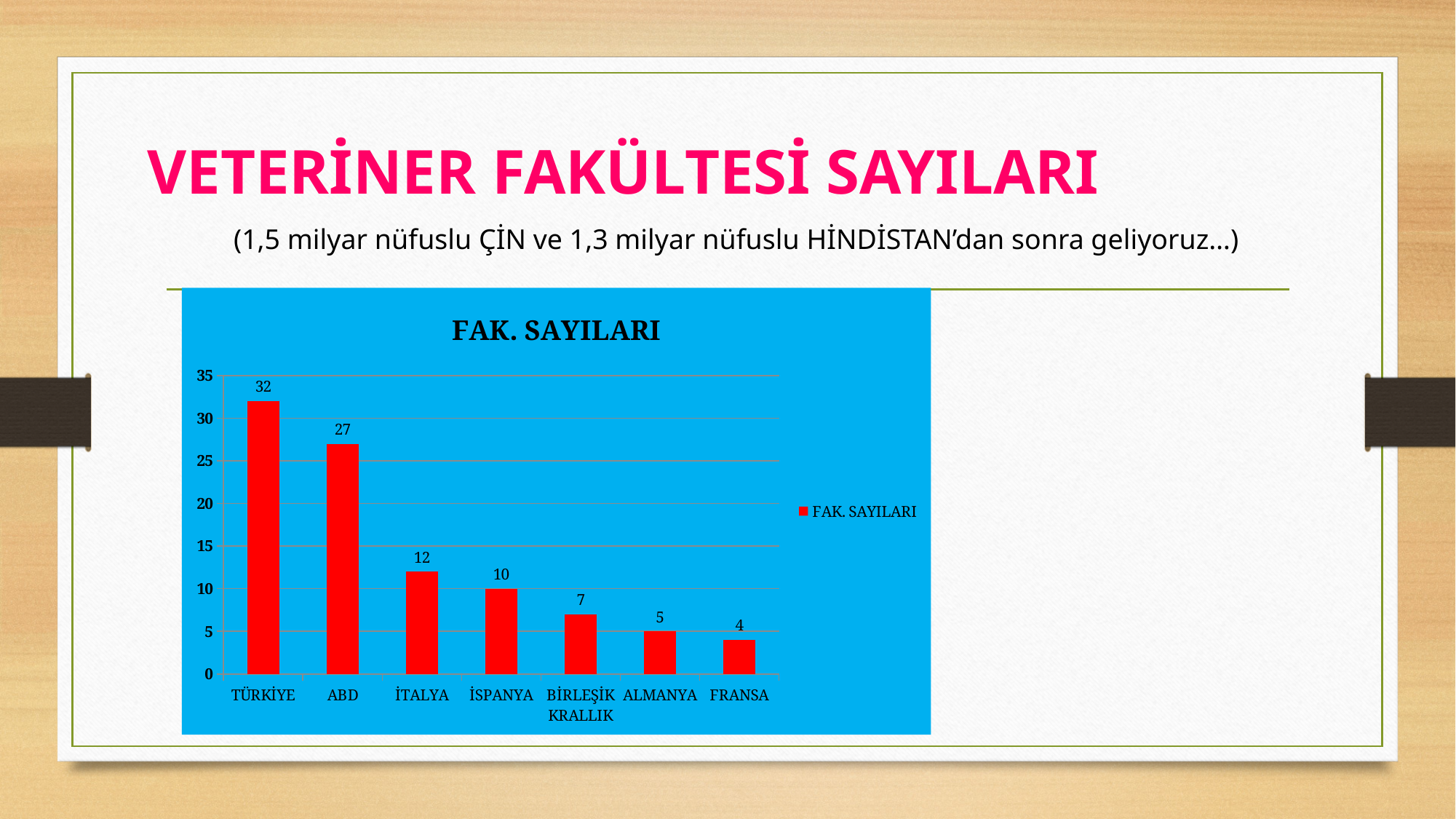
Which category has the lowest value in the FAK. SAYILARI chart? FRANSA Which category has the highest value in the FAK. SAYILARI chart? TÜRKİYE Do the values rise or fall from left to right along the x axis? Fall Which is larger, the value for ALMANYA or the value for FRANSA? ALMANYA What is the value for TÜRKİYE in the FAK. SAYILARI chart? 32 How many series does the legend list? 1 How many categories are shown on the x axis of the FAK. SAYILARI chart? 7 What is the value for ABD in the FAK. SAYILARI chart? 27 What is the difference between the values for İTALYA and İSPANYA? 2 What is the difference between the values for TÜRKİYE and ABD? 5 What is the value for BİRLEŞİK KRALLIK in the FAK. SAYILARI chart? 7 What kind of chart is shown on the slide? Bar chart